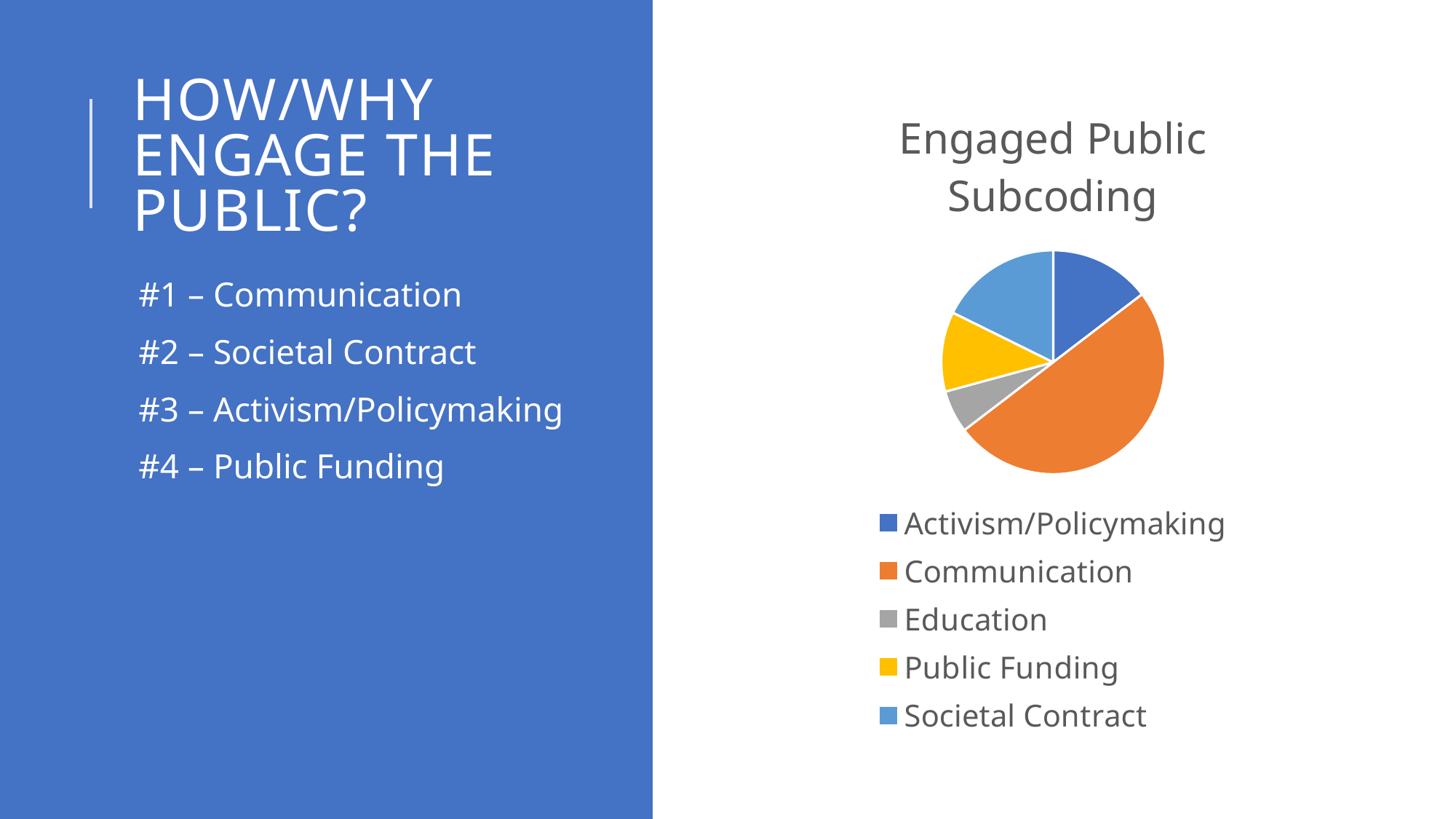
What is the title of the chart? Engaged Public Subcoding How many categories does the pie chart have? 5 Which slice is larger, Communication or Activism/Policymaking? Communication Which slice is larger, Societal Contract or Public Funding? Societal Contract What colour is the Communication slice? orange How many entries does the chart legend list? 5 What kind of chart is shown on the slide? pie chart Which slice is larger, Societal Contract or Education? Societal Contract Which category has the largest slice of the pie? Communication Which category has the smallest slice of the pie? Education